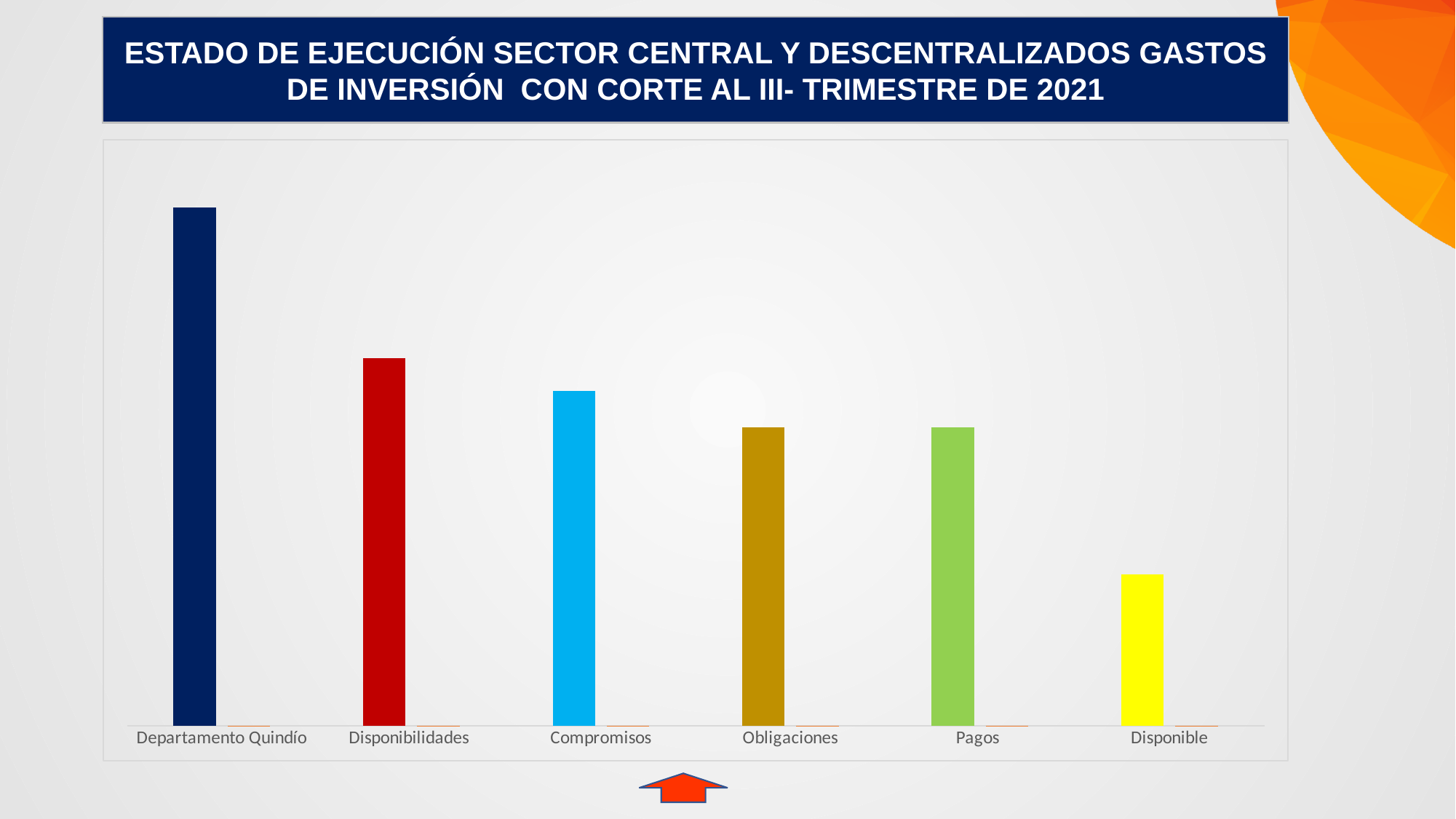
Which is larger, the value for Departamento Quindío or the value for Disponibilidades? Departamento Quindío Do the bar values generally rise or fall from left to right along the x axis? fall Which category has the highest bar? Departamento Quindío Which is larger, the value for Pagos or the value for Disponible? Pagos How many categories are plotted in the chart? 6 What kind of chart is shown on the slide? bar chart Which is larger, the value for Compromisos or the value for Obligaciones? Compromisos What colour is the bar for Disponible? yellow What is the label of the first category on the x axis? Departamento Quindío Which category has the lowest bar? Disponible